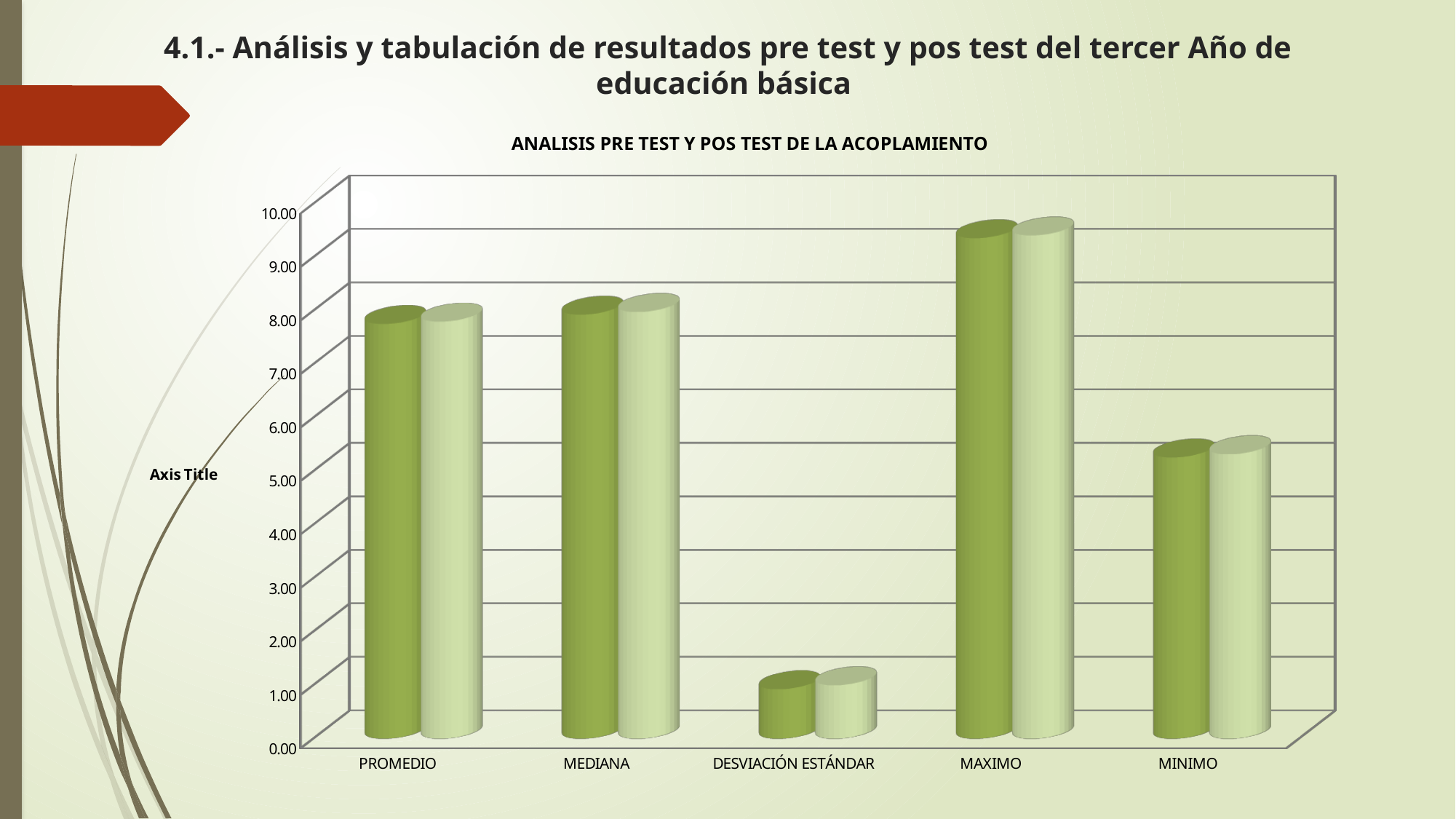
Are the values for PROMEDIO greater or less than 9.00? less Are the values for MEDIANA greater or less than 6.00? greater Which category has the lowest bars in the chart? DESVIACIÓN ESTÁNDAR How many categories are shown on the x axis of the chart? 5 What kind of chart is shown on the slide? bar chart Which category has larger values, PROMEDIO or DESVIACIÓN ESTÁNDAR? PROMEDIO Are the values for MAXIMO greater or less than 9.00? greater Which category has the highest bars in the chart? MAXIMO What is the title of the chart? ANALISIS PRE TEST Y POS TEST DE LA ACOPLAMIENTO Which category has larger values, MAXIMO or MINIMO? MAXIMO